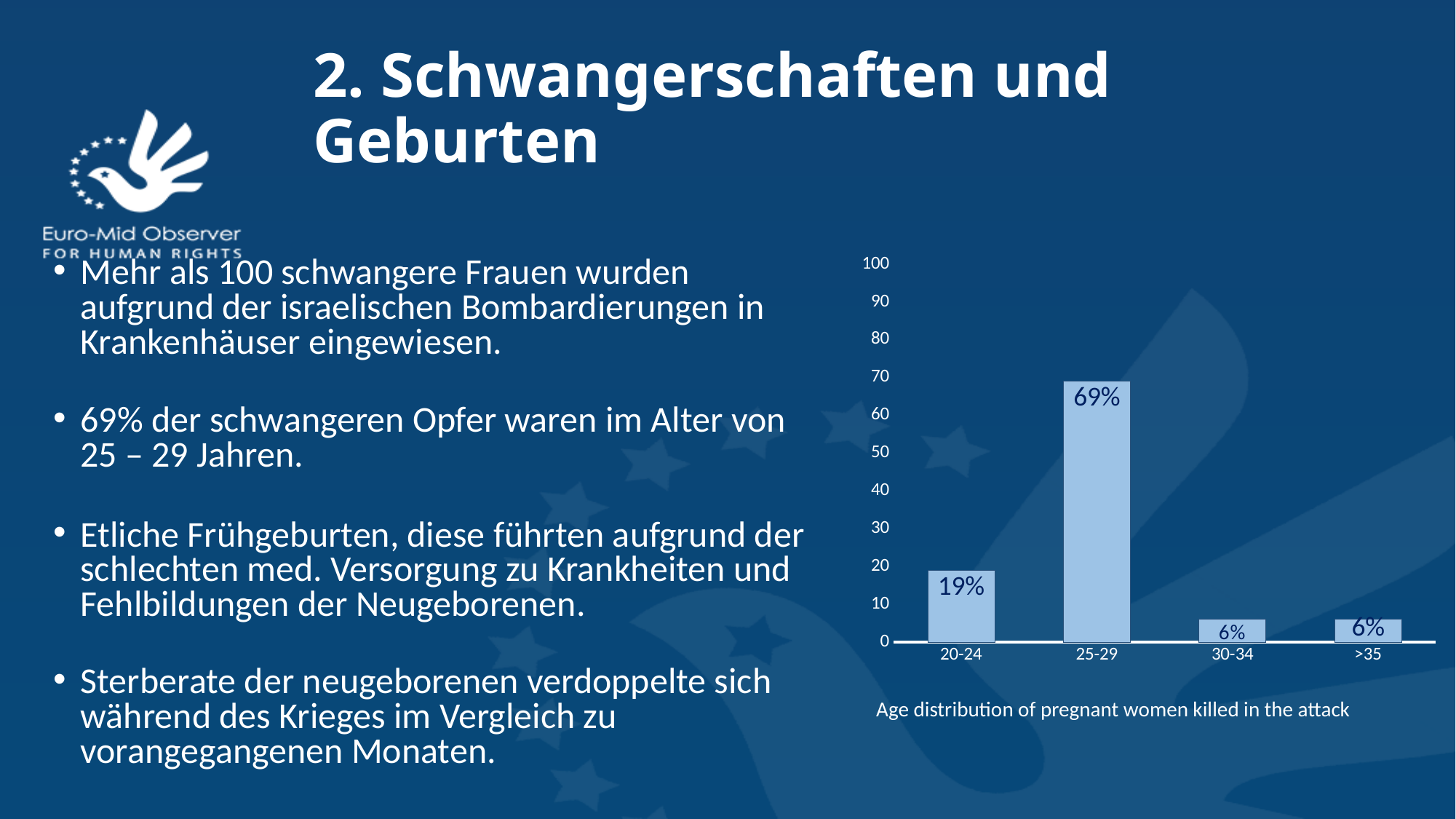
What is the value for the 30-34 age group? 6% Is the value for >35 greater or less than 10? less Is the value for 25-29 greater or less than 60? greater Which age group has the highest value? 25-29 What is the value for the 25-29 age group? 69% How many age groups are shown on the x axis? 4 Which is larger, the value for 20-24 or the value for 30-34? 20-24 What is the value for the 20-24 age group? 19% What is the highest value shown on the y axis? 100 What is the difference between the values for 25-29 and 20-24? 50% What kind of chart is shown on the slide? bar chart What is the caption below the chart? Age distribution of pregnant women killed in the attack